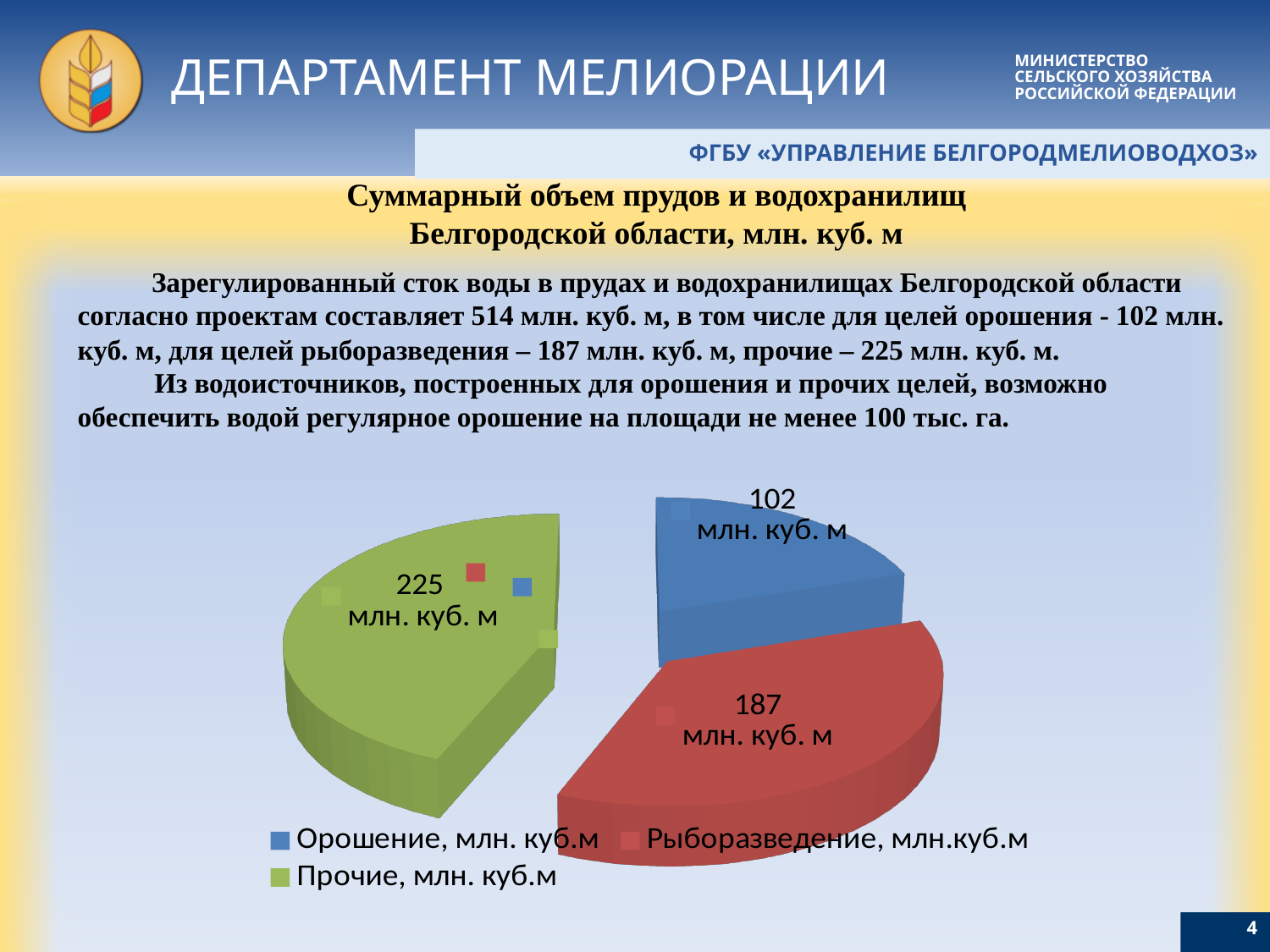
How many slices does the pie chart have? 3 What is the value for Орошение in the pie chart? 102 млн. куб. м Which category has the smallest slice in the pie chart? Орошение How many entries does the legend list? 3 Which is larger, the value for Рыборазведение or the value for Прочие? Прочие What is the value for Рыборазведение in the pie chart? 187 млн. куб. м What type of chart is shown on the slide? pie chart What is the difference between the values for Рыборазведение and Орошение? 85 млн. куб. м What is the value for Прочие in the pie chart? 225 млн. куб. м What is the difference between the values for Прочие and Орошение? 123 млн. куб. м Which category has the largest slice in the pie chart? Прочие What colour is the slice for Рыборазведение? red